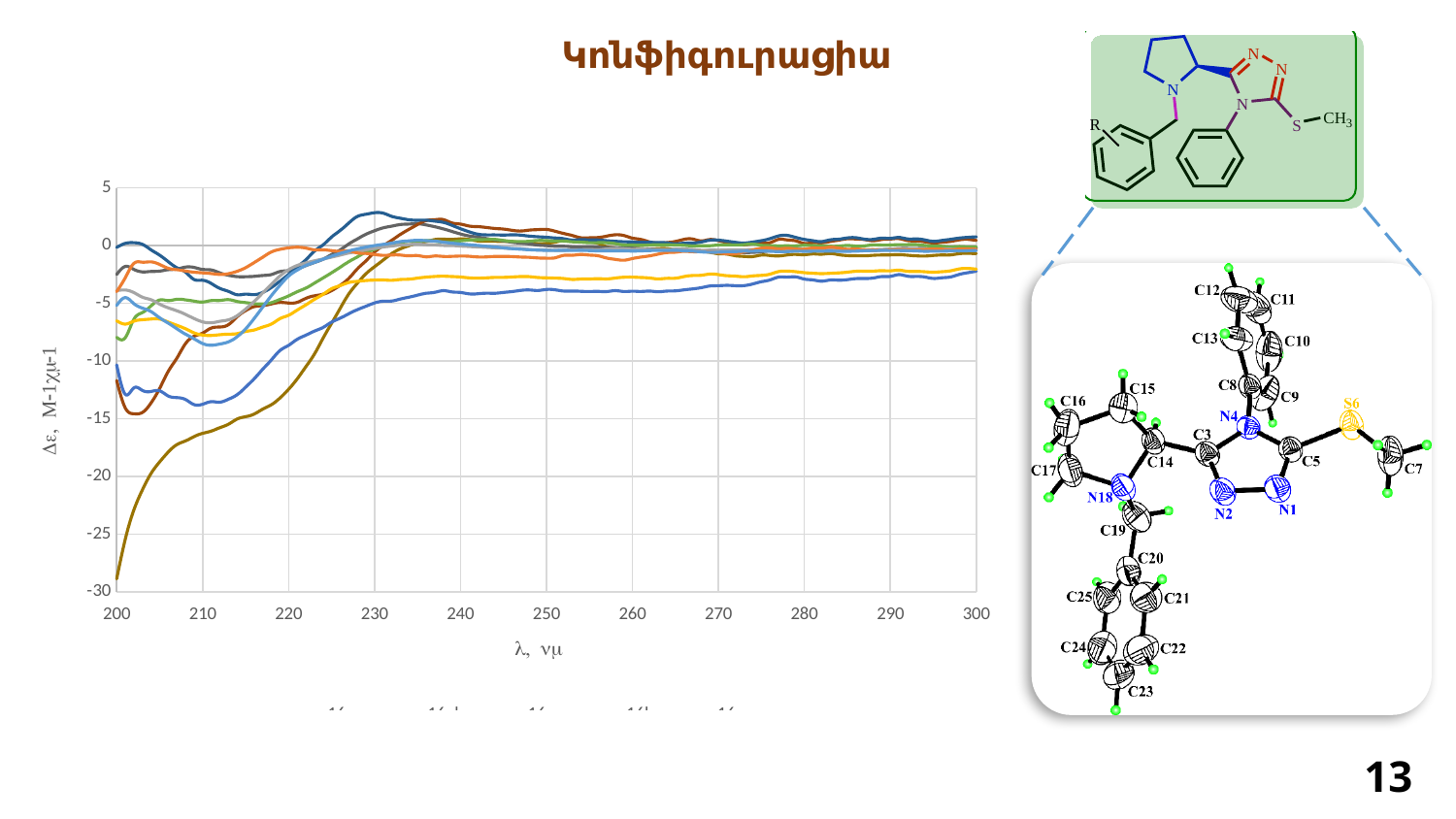
Is the value of the dark yellow (olive) line at 210 nm greater or less than -10? less Is the value of the blue line at 250 nm greater or less than -5? greater Does the dark yellow (olive) line rise or fall between 200 nm and 230 nm? rise Is the value of the lowest line at 300 nm greater or less than -5? greater What is the label of the x axis of the chart? λ, νμ What kind of chart is shown on the slide? line chart How many labelled tick marks are there on the x axis of the chart? 11 What is the lowest value shown on the y axis of the chart? -30